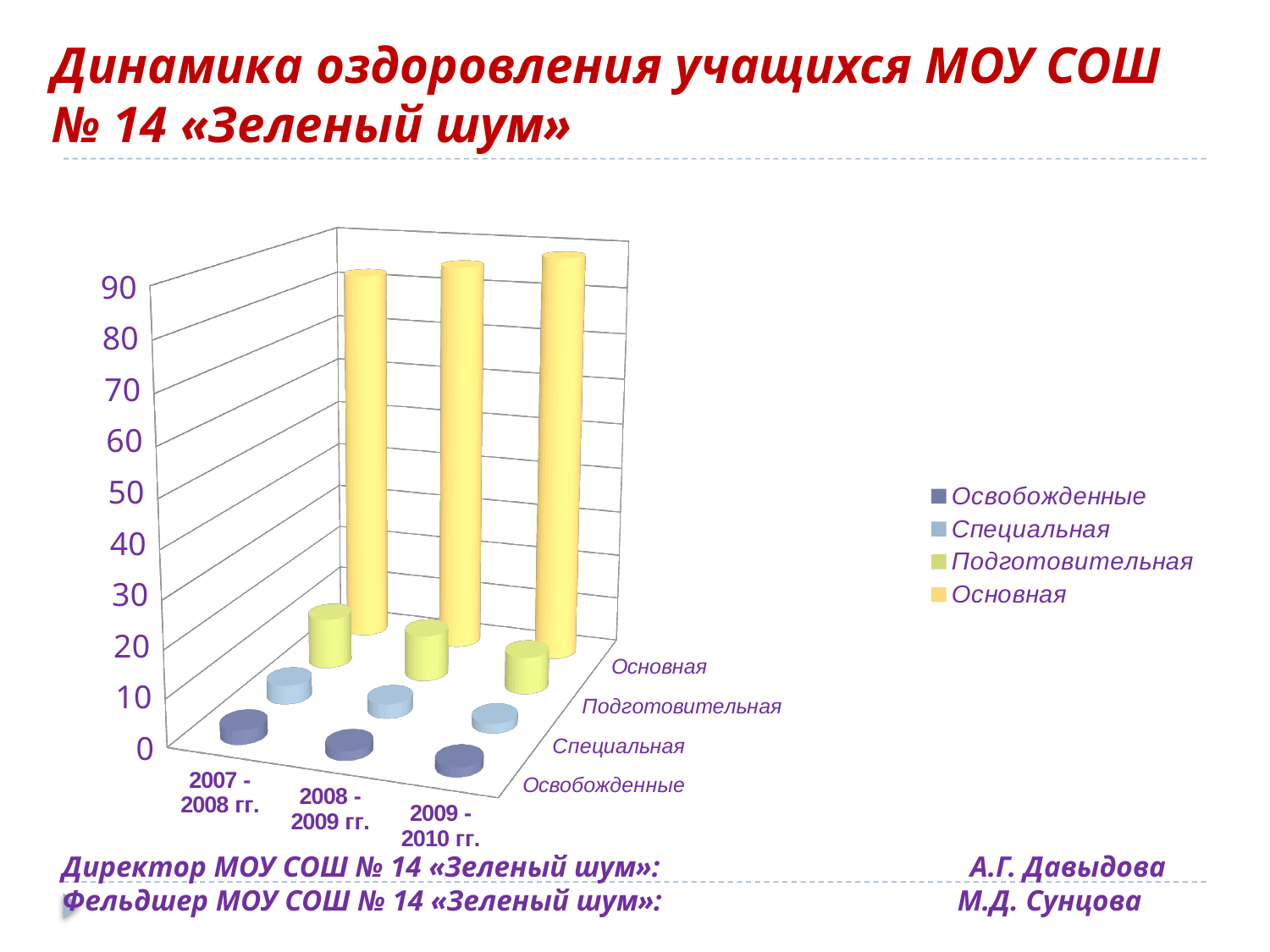
How many series does the legend list? 4 Which is larger in 2009 - 2010 гг.: Основная or Подготовительная? Основная Is the value for Специальная in 2009 - 2010 гг. greater or less than 20? less What kind of chart is shown on the slide? bar chart Do the values for Основная rise or fall from 2007 - 2008 гг. to 2009 - 2010 гг.? rise Is the value for Основная in 2009 - 2010 гг. greater or less than 50? greater Which series has the highest values in every school year? Основная How many school-year categories are shown on the x axis? 3 Is the value for Освобожденные in 2007 - 2008 гг. greater or less than 10? less What is the title of the slide containing the chart? Динамика оздоровления учащихся МОУ СОШ № 14 «Зеленый шум» Which series is shown in yellow in the legend? Основная